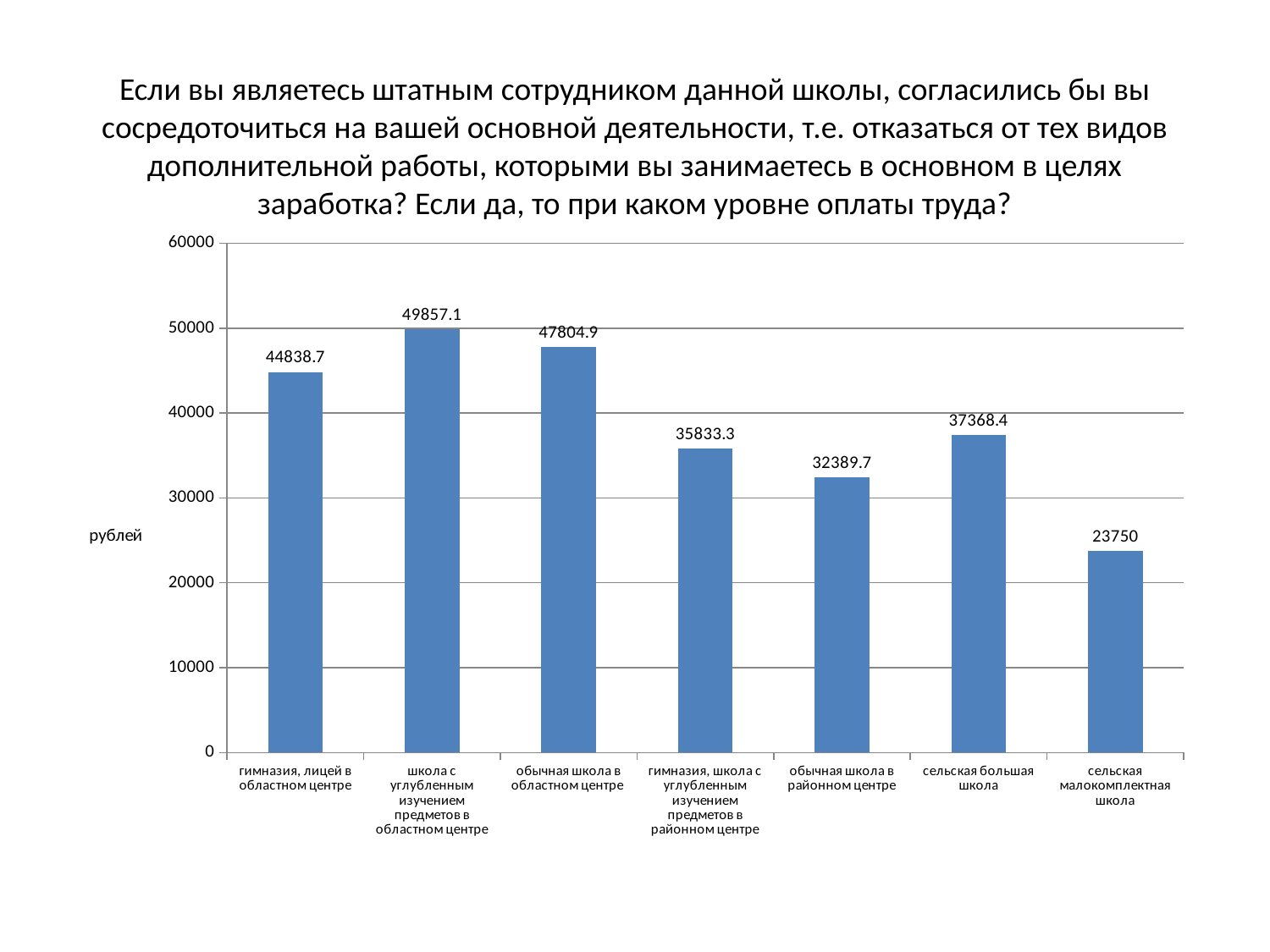
What is the difference between "гимназия, лицей в областном центре" and "обычная школа в районном центре"? 12449 Is the value for "сельская малокомплектная школа" greater or less than 30000? less What is the value for "обычная школа в районном центре"? 32389.7 What is the difference between the highest value (49857.1) and the lowest value (23750)? 26107.1 Which is larger: the value for "обычная школа в областном центре" or the value for "гимназия, школа с углубленным изучением предметов в районном центре"? обычная школа в областном центре What unit is shown on the vertical axis label? рублей Which category has the lowest value? сельская малокомплектная школа Which category has the highest value? школа с углубленным изучением предметов в областном центре How many categories are shown in the chart? 7 What kind of chart is shown on the slide? bar chart What is the value for "сельская большая школа"? 37368.4 What is the value for "гимназия, лицей в областном центре"? 44838.7